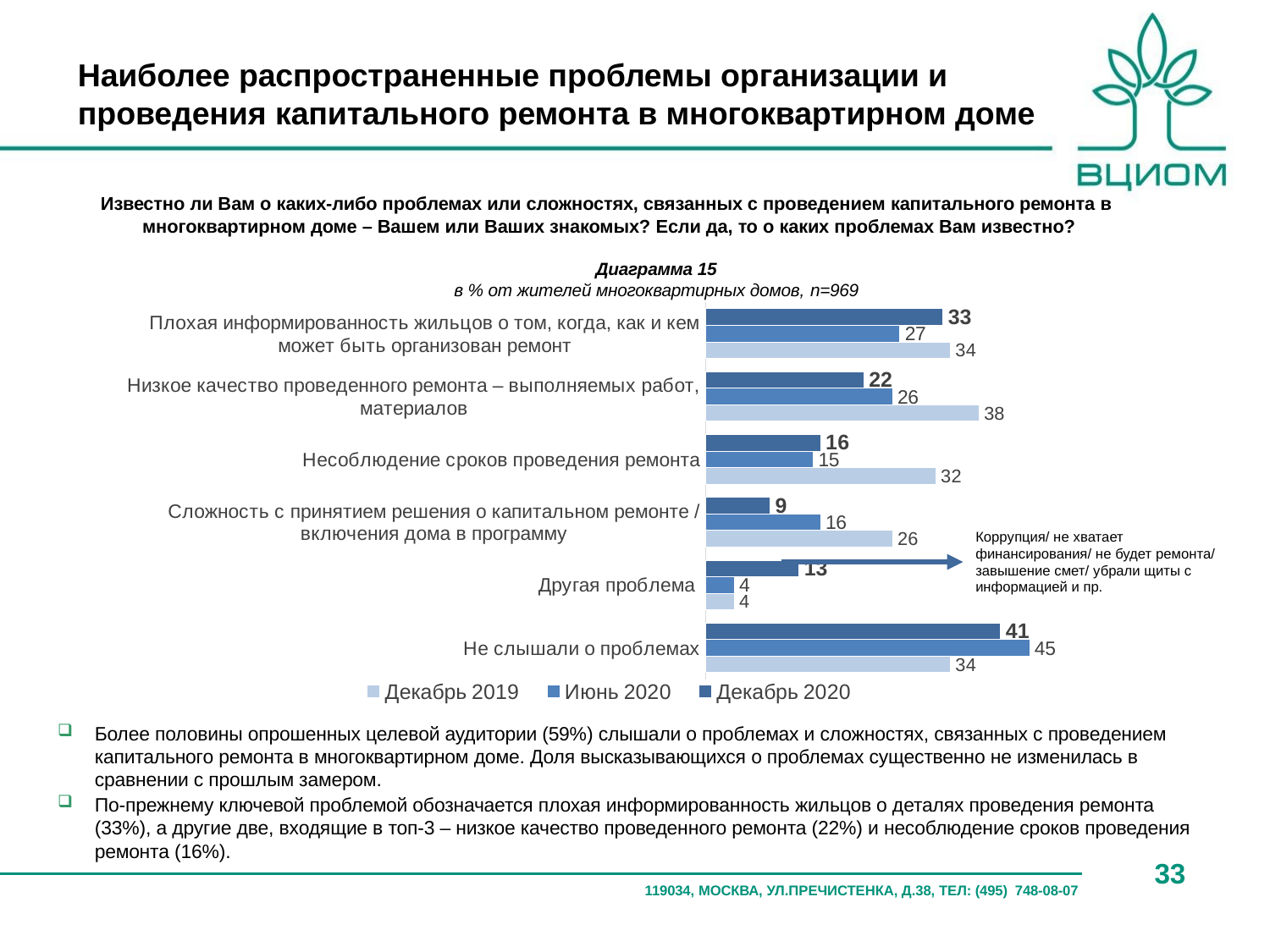
Какое значение показано для категории «Сложность с принятием решения о капитальном ремонте / включения дома в программу» в серии «Декабрь 2020»? 9 Что больше в категории «Не слышали о проблемах»: значение серии «Июнь 2020» или серии «Декабрь 2019»? Июнь 2020 Какого типа эта диаграмма? Столбчатая (bar chart) Какое значение показано для категории «Не слышали о проблемах» в серии «Июнь 2020»? 45 Сколько серий перечислено в легенде диаграммы? 3 В какой категории значение серии «Декабрь 2020» наибольшее? Не слышали о проблемах Какое значение показано для категории «Плохая информированность жильцов о том, когда, как и кем может быть организован ремонт» в серии «Декабрь 2020»? 33 Какое значение показано для категории «Низкое качество проведенного ремонта – выполняемых работ, материалов» в серии «Декабрь 2019»? 38 На сколько значение серии «Декабрь 2019» больше значения серии «Декабрь 2020» в категории «Несоблюдение сроков проведения ремонта»? 16 В какой категории значение серии «Декабрь 2019» наименьшее? Другая проблема Сколько категорий показано на диаграмме? 6 Какие серии перечислены в легенде диаграммы? Декабрь 2019, Июнь 2020, Декабрь 2020